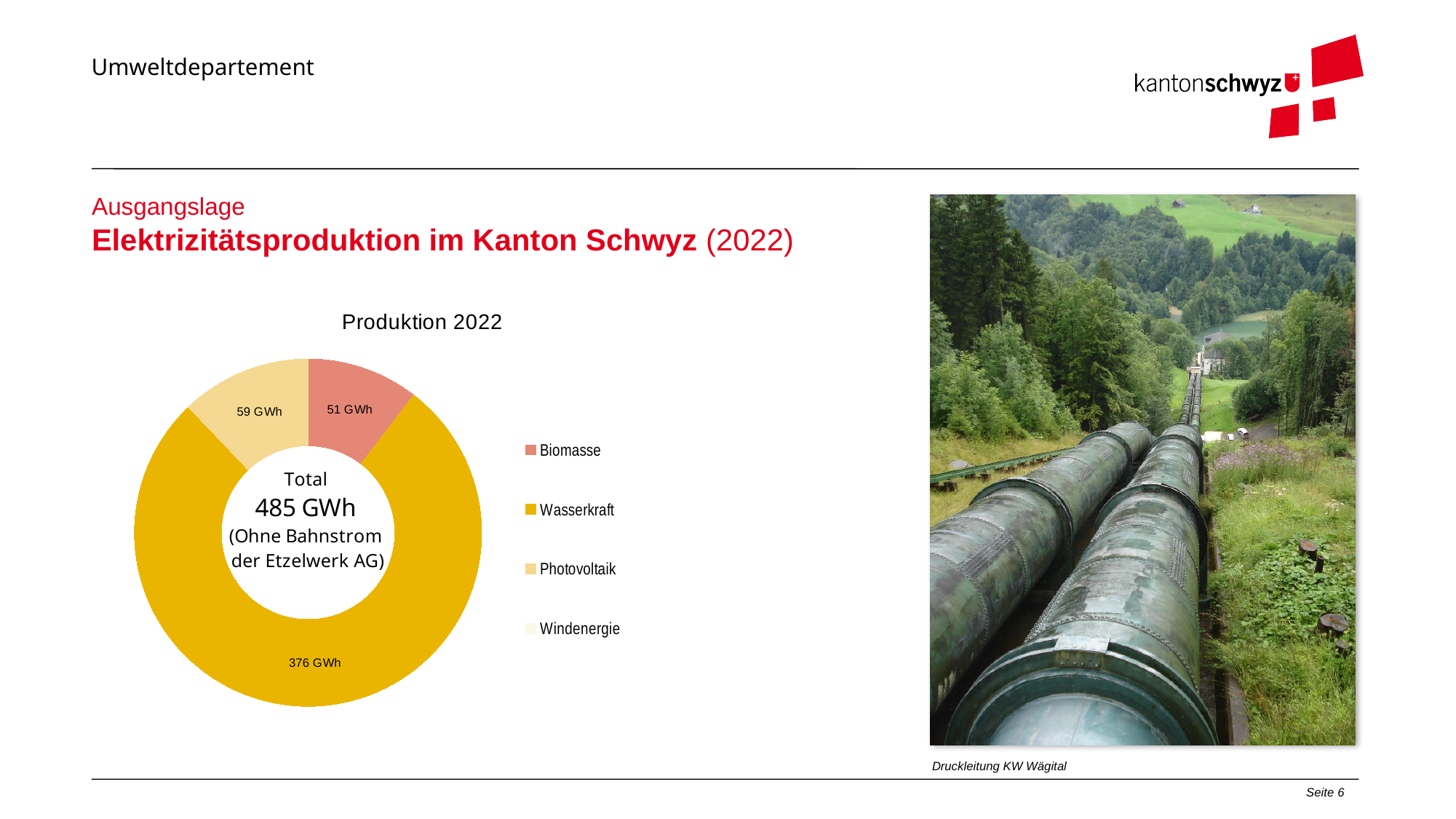
How many entries does the legend of the Produktion 2022 chart list? 4 What is the difference between Photovoltaik and Biomasse in the Produktion 2022 chart? 8 GWh Which is larger in the Produktion 2022 chart, Photovoltaik or Biomasse? Photovoltaik What total is shown in the centre of the Produktion 2022 chart? 485 GWh What is the difference between Wasserkraft and Photovoltaik in the Produktion 2022 chart? 317 GWh Which of the labelled slices in the Produktion 2022 chart is the smallest? Biomasse What is the value for Wasserkraft in the Produktion 2022 chart? 376 GWh What is the value for Photovoltaik in the Produktion 2022 chart? 59 GWh What kind of chart is the Produktion 2022 chart? doughnut chart Which category has the largest slice in the Produktion 2022 chart? Wasserkraft What is the value for Biomasse in the Produktion 2022 chart? 51 GWh What colour represents Wasserkraft in the Produktion 2022 chart? yellow